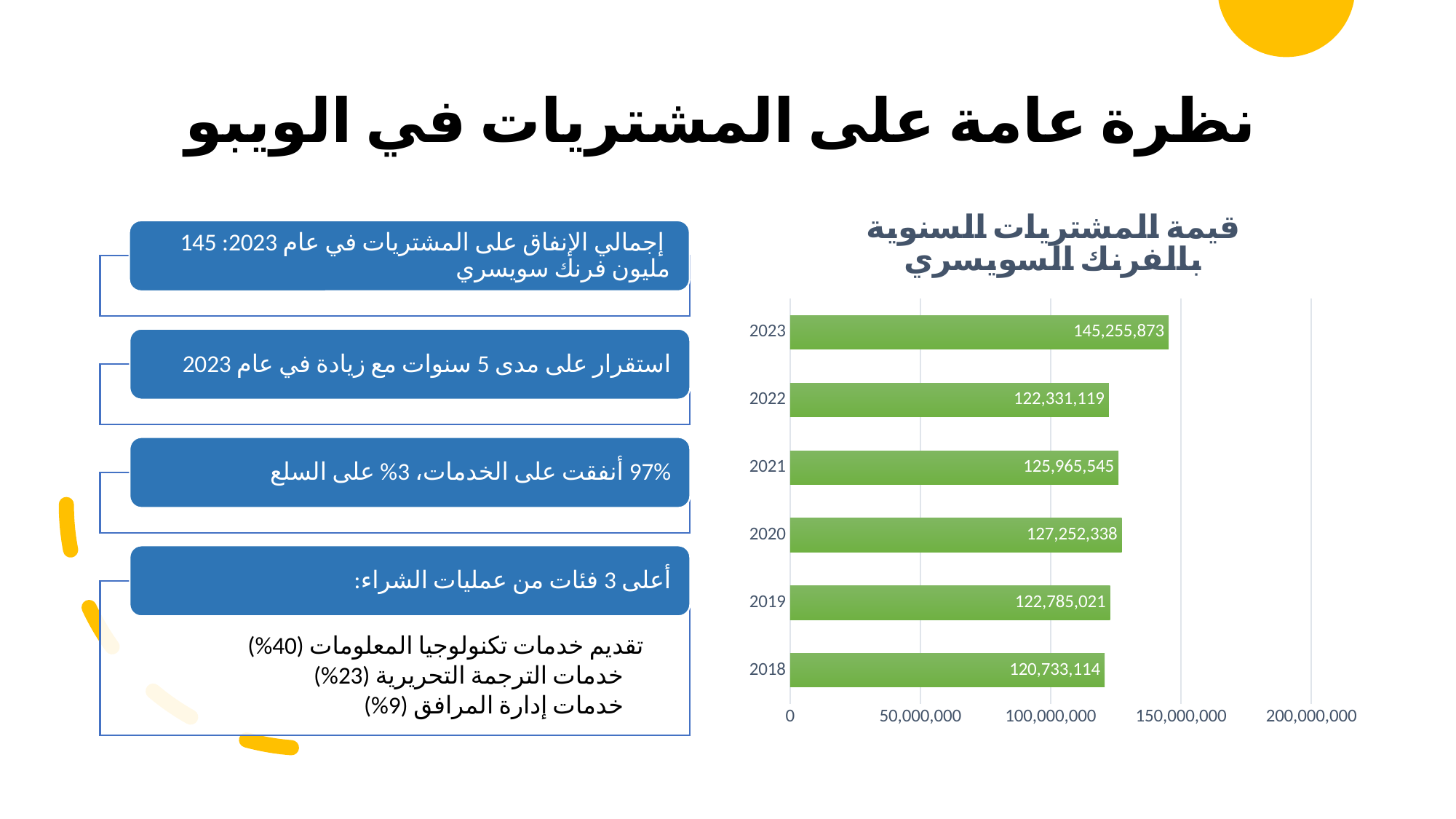
How many years are shown in the chart? 6 Which is larger, the value for 2020 or the value for 2018? 2020 What is the value for 2018 in the chart? 120,733,114 What is the difference between the values for 2020 and 2019? 4,467,317 What kind of chart is shown on the slide? bar chart Which year has the lowest value in the chart? 2018 Is the value for 2018 greater or less than 150,000,000? less What is the value for 2020 in the chart? 127,252,338 Which year has the highest value in the chart? 2023 Is the value for 2023 greater or less than 100,000,000? greater What is the difference between the values for 2023 and 2022? 22,924,754 What is the value for 2023 in the chart? 145,255,873